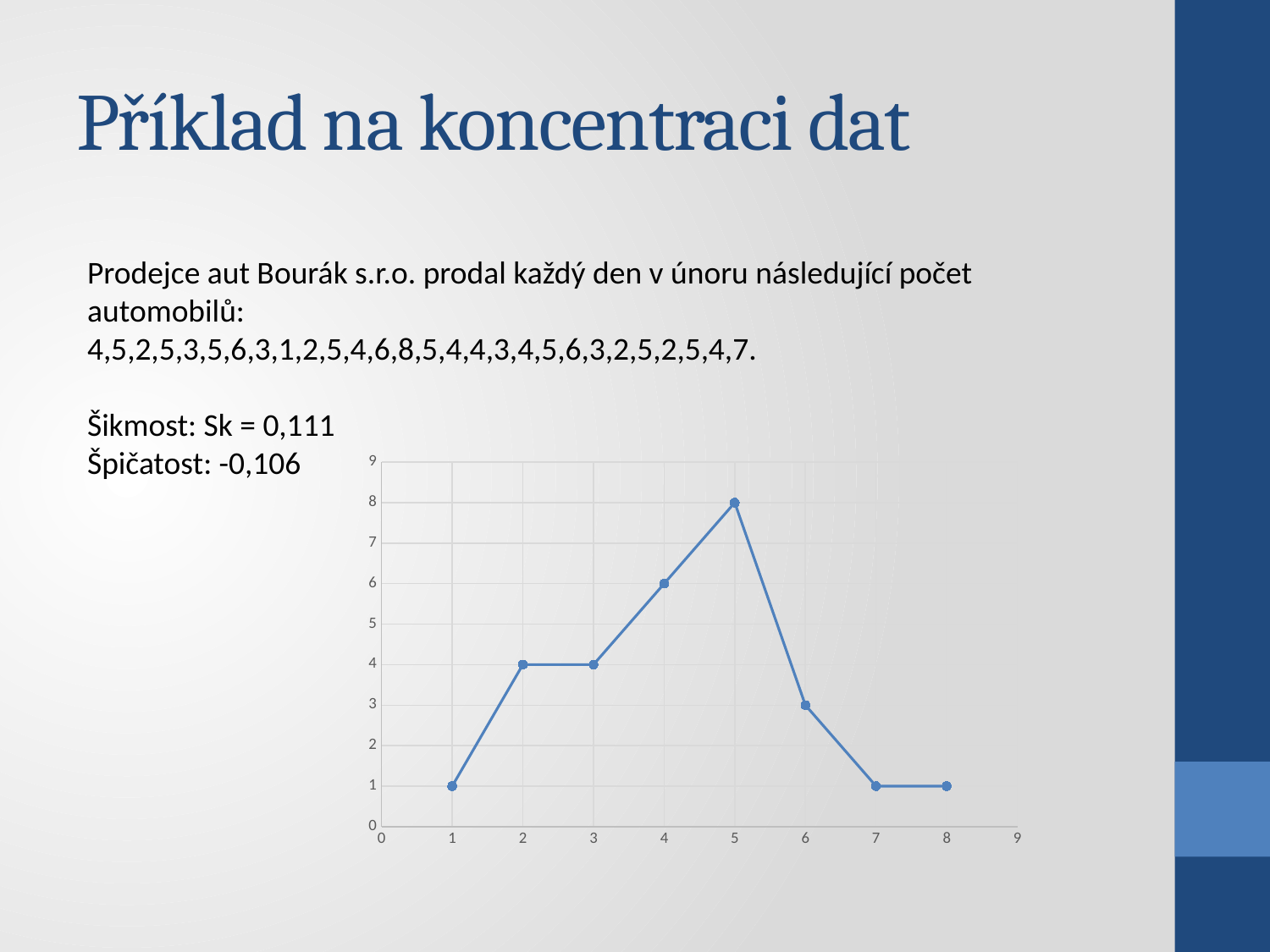
How many data points are plotted on the chart? 8 Does the line rise or fall between x = 5 and x = 7? fall What is the y value of the point at x = 5? 8 What is the y value of the point at x = 2? 4 What is the y value of the point at x = 6? 3 At which x value does the line reach its highest point? 5 What is the lowest y value plotted on the chart? 1 What kind of chart is shown on the slide? line chart Which has a larger y value: the point at x = 4 or the point at x = 6? x = 4 What is the difference between the y values at x = 5 and x = 6? 5 What is the y value of the point at x = 4? 6 What is the maximum value shown on the y axis? 9